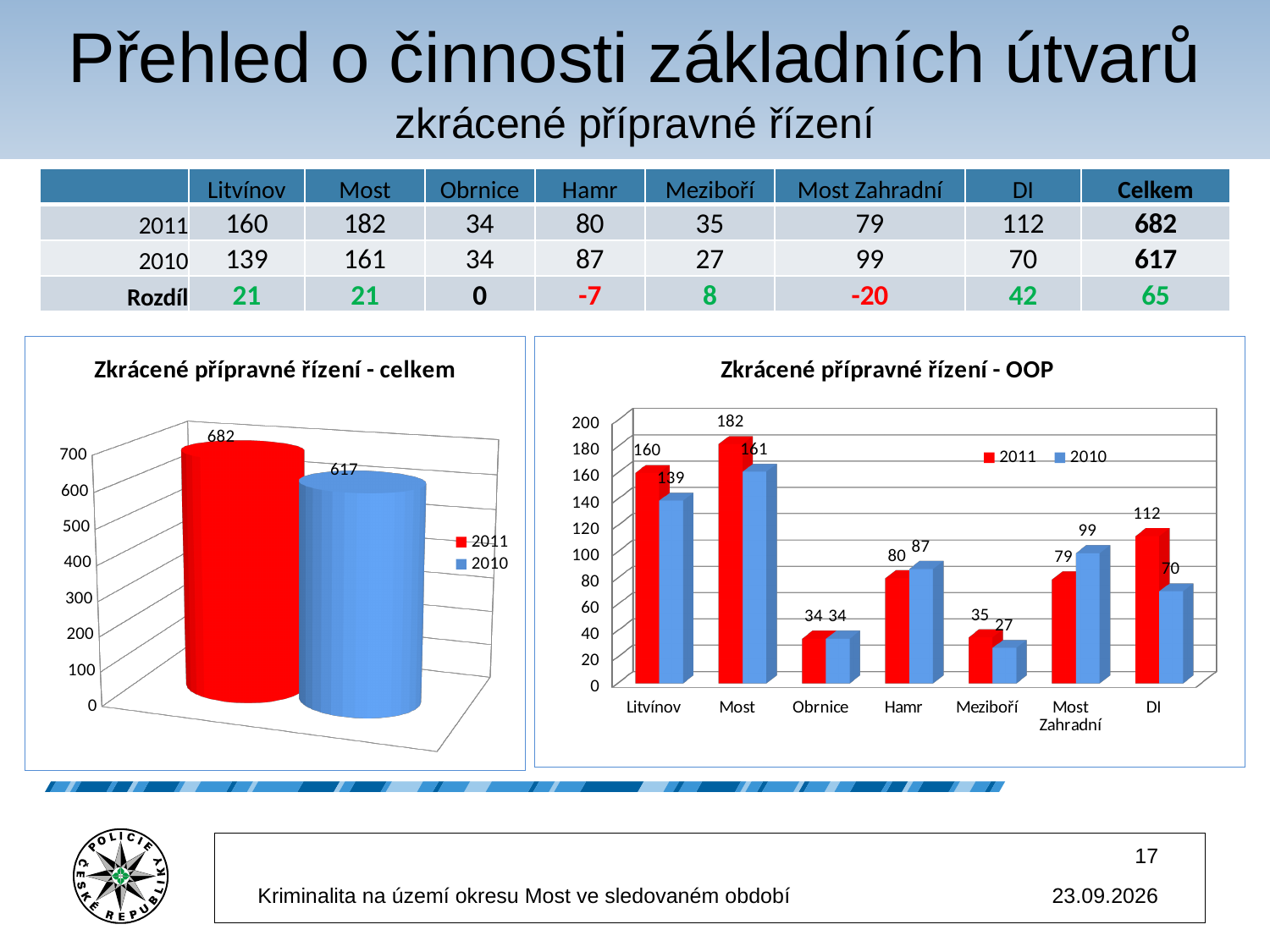
In the chart 'Zkrácené přípravné řízení - OOP', which category has the highest 2011 value? Most What kind of chart is 'Zkrácené přípravné řízení - OOP'? Bar chart In the chart 'Zkrácené přípravné řízení - celkem', what is the difference between the 2011 and 2010 values? 65 In the chart 'Zkrácené přípravné řízení - OOP', which category has the lowest 2010 value? Meziboří In the chart 'Zkrácené přípravné řízení - celkem', what is the value for 2010? 617 In the chart 'Zkrácené přípravné řízení - OOP', what is the 2011 value for Most? 182 In the chart 'Zkrácené přípravné řízení - OOP', what is the difference between the 2011 and 2010 values for DI? 42 How many categories are shown on the x axis of the chart 'Zkrácené přípravné řízení - OOP'? 7 In the chart 'Zkrácené přípravné řízení - OOP', which is larger for Hamr: the 2011 value or the 2010 value? 2010 In the chart 'Zkrácené přípravné řízení - celkem', what is the value for 2011? 682 How many series does the legend of the chart 'Zkrácené přípravné řízení - OOP' list? 2 In the chart 'Zkrácené přípravné řízení - OOP', what is the 2010 value for Most Zahradní? 99